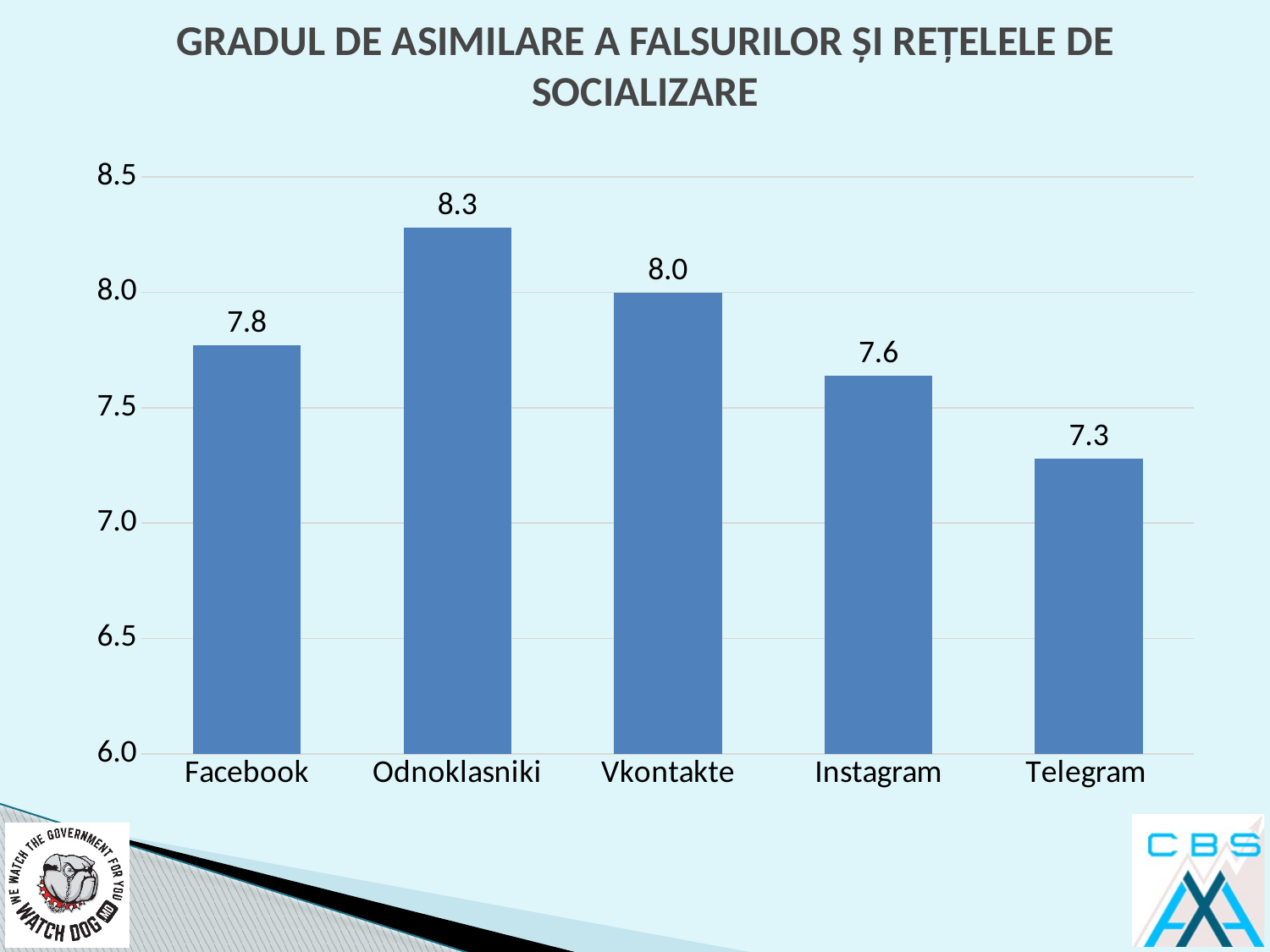
What is the title of the chart? GRADUL DE ASIMILARE A FALSURILOR ȘI REȚELELE DE SOCIALIZARE What is the difference between the values for Vkontakte and Instagram? 0.4 What is the value for Facebook? 7.8 Which is larger, the value for Facebook or the value for Instagram? Facebook What is the value for Telegram? 7.3 How many social networks are shown on the chart? 5 Is the value for Vkontakte greater or less than 7.5? greater What is the value for Odnoklasniki? 8.3 Which social network has the lowest value? Telegram Which social network has the highest value? Odnoklasniki What is the difference between the values for Odnoklasniki and Telegram? 1.0 What kind of chart is shown on the slide? bar chart